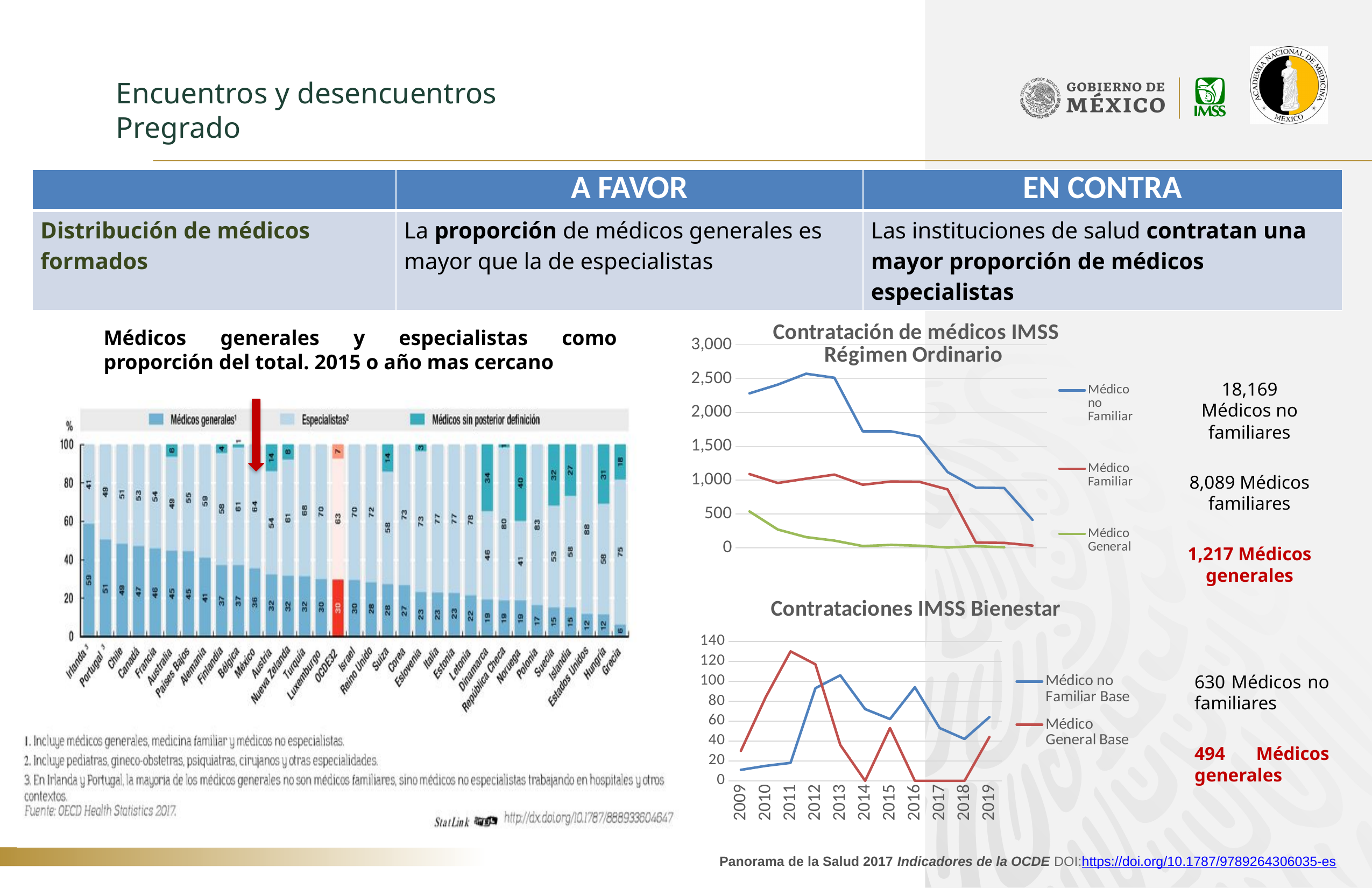
In the OECD chart 'Médicos generales y especialistas como proporción del total', what is the value for Especialistas in Grecia? 75 In the OECD chart 'Médicos generales y especialistas como proporción del total', what is the value for Médicos generales in México? 36 In the 'Contrataciones IMSS Bienestar' chart, how many series does the legend list? 2 In the 'Contratación de médicos IMSS Régimen Ordinario' chart, how many series does the legend list? 3 In the 'Contrataciones IMSS Bienestar' chart, in which year does Médico General Base reach its highest value? 2011 In the 'Contratación de médicos IMSS Régimen Ordinario' chart, does the Médico no Familiar series rise or fall overall from left to right? fall In the 'Contratación de médicos IMSS Régimen Ordinario' chart, is the first value of the Médico no Familiar series greater or less than 2,000? greater In the 'Contrataciones IMSS Bienestar' chart, which series has the larger value in 2011, Médico no Familiar Base or Médico General Base? Médico General Base In the 'Contrataciones IMSS Bienestar' chart, what kind of chart is shown? line chart In the 'Contrataciones IMSS Bienestar' chart, is the value for Médico General Base in 2011 greater or less than 120? greater In the 'Contrataciones IMSS Bienestar' chart, how many years are shown on the x axis? 11 In the 'Contrataciones IMSS Bienestar' chart, is the value for Médico no Familiar Base in 2009 greater or less than 20? less